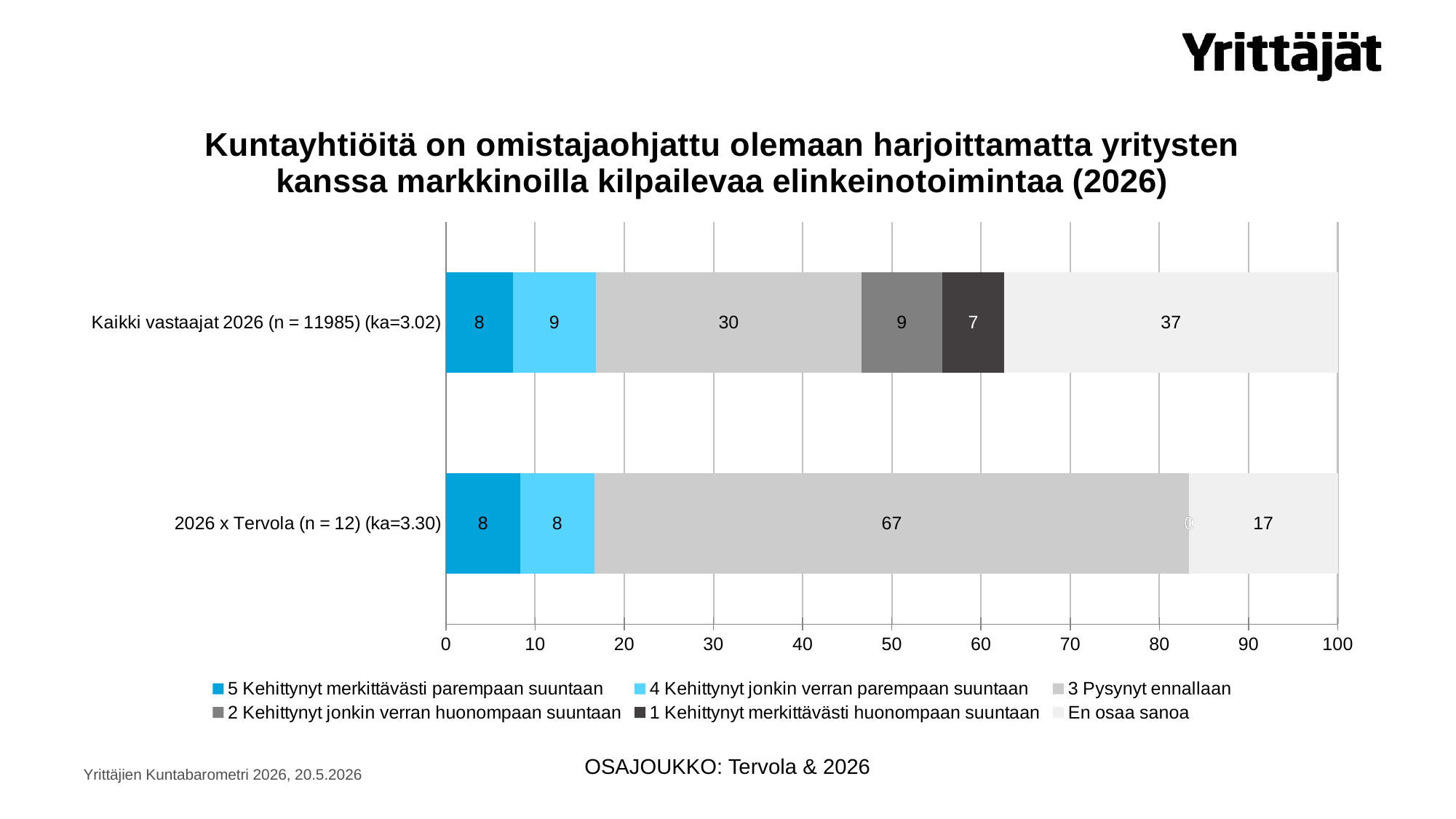
Which category has the higher value for '3 Pysynyt ennallaan'? 2026 x Tervola (n = 12) (ka=3.30) What is the value of '3 Pysynyt ennallaan' for '2026 x Tervola (n = 12) (ka=3.30)'? 67 What is the value of '1 Kehittynyt merkittävästi huonompaan suuntaan' for 'Kaikki vastaajat 2026 (n = 11985) (ka=3.02)'? 7 What is the difference between the 'En osaa sanoa' values of 'Kaikki vastaajat 2026 (n = 11985) (ka=3.02)' and '2026 x Tervola (n = 12) (ka=3.30)'? 20 What is the value of 'En osaa sanoa' for 'Kaikki vastaajat 2026 (n = 11985) (ka=3.02)'? 37 What is the value of '4 Kehittynyt jonkin verran parempaan suuntaan' for '2026 x Tervola (n = 12) (ka=3.30)'? 8 What type of chart is shown on the slide? Stacked bar chart What is the difference between the '3 Pysynyt ennallaan' values of '2026 x Tervola (n = 12) (ka=3.30)' and 'Kaikki vastaajat 2026 (n = 11985) (ka=3.02)'? 37 Which segment is the largest in the bar for 'Kaikki vastaajat 2026 (n = 11985) (ka=3.02)'? En osaa sanoa How many series does the legend list? 6 How many categories (bars) does the chart show? 2 What is the title of the chart? Kuntayhtiöitä on omistajaohjattu olemaan harjoittamatta yritysten kanssa markkinoilla kilpailevaa elinkeinotoimintaa (2026)